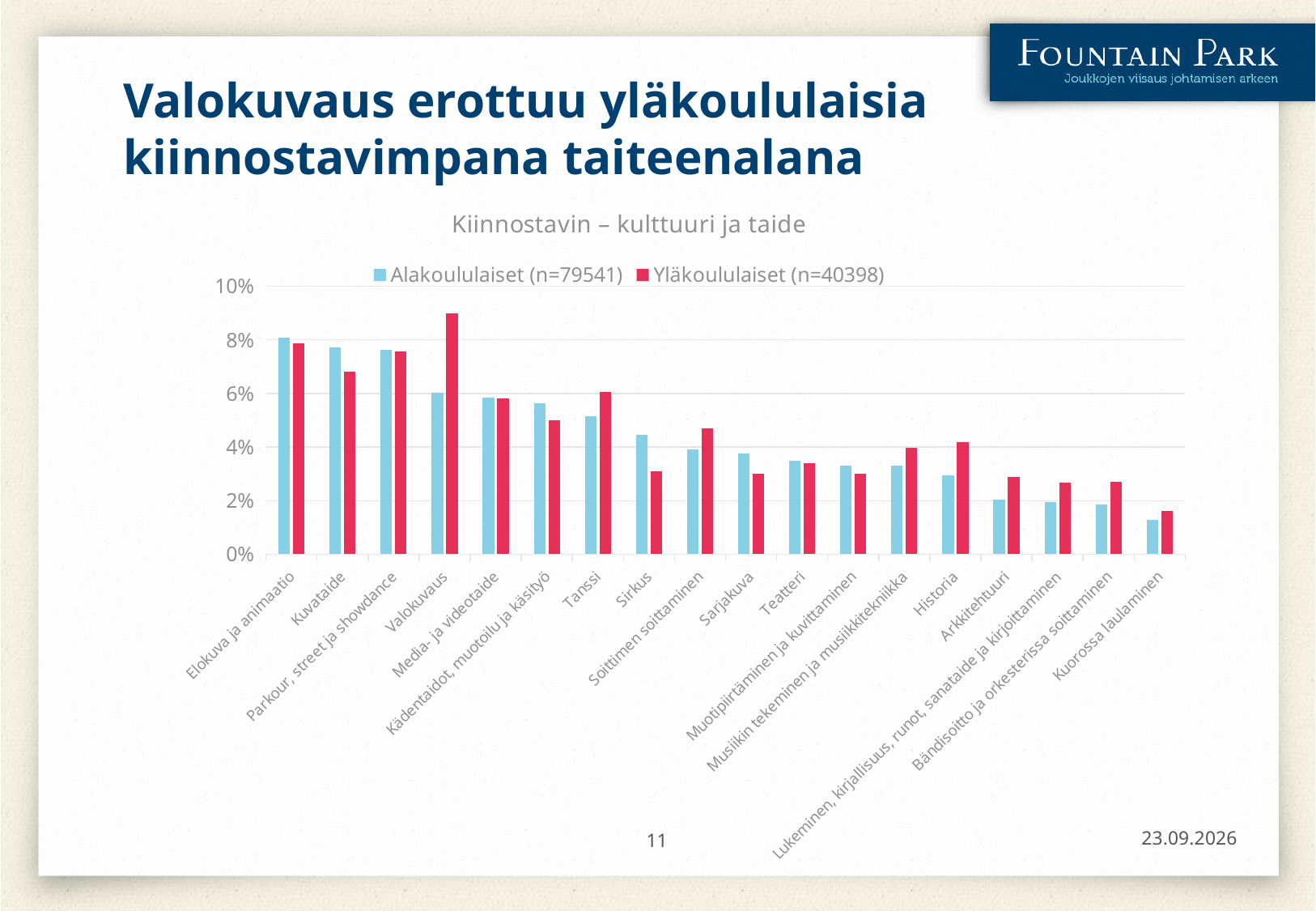
Is the Alakoululaiset value for Kuorossa laulaminen greater or less than 2%? less How many categories are shown on the x axis? 18 For Valokuvaus, which series has the larger value, Alakoululaiset or Yläkoululaiset? Yläkoululaiset Is the Yläkoululaiset value for Kuvataide greater or less than 8%? less Which category has the lowest value for Alakoululaiset (n=79541)? Kuorossa laulaminen For Sirkus, which series has the larger value, Alakoululaiset or Yläkoululaiset? Alakoululaiset What kind of chart is shown on the slide? bar chart Do the Alakoululaiset values generally rise or fall from left to right along the x axis? fall Which category has the highest value for Yläkoululaiset (n=40398)? Valokuvaus What is the title of the chart? Kiinnostavin – kulttuuri ja taide How many series does the legend list? 2 Is the Yläkoululaiset value for Valokuvaus greater or less than 8%? greater